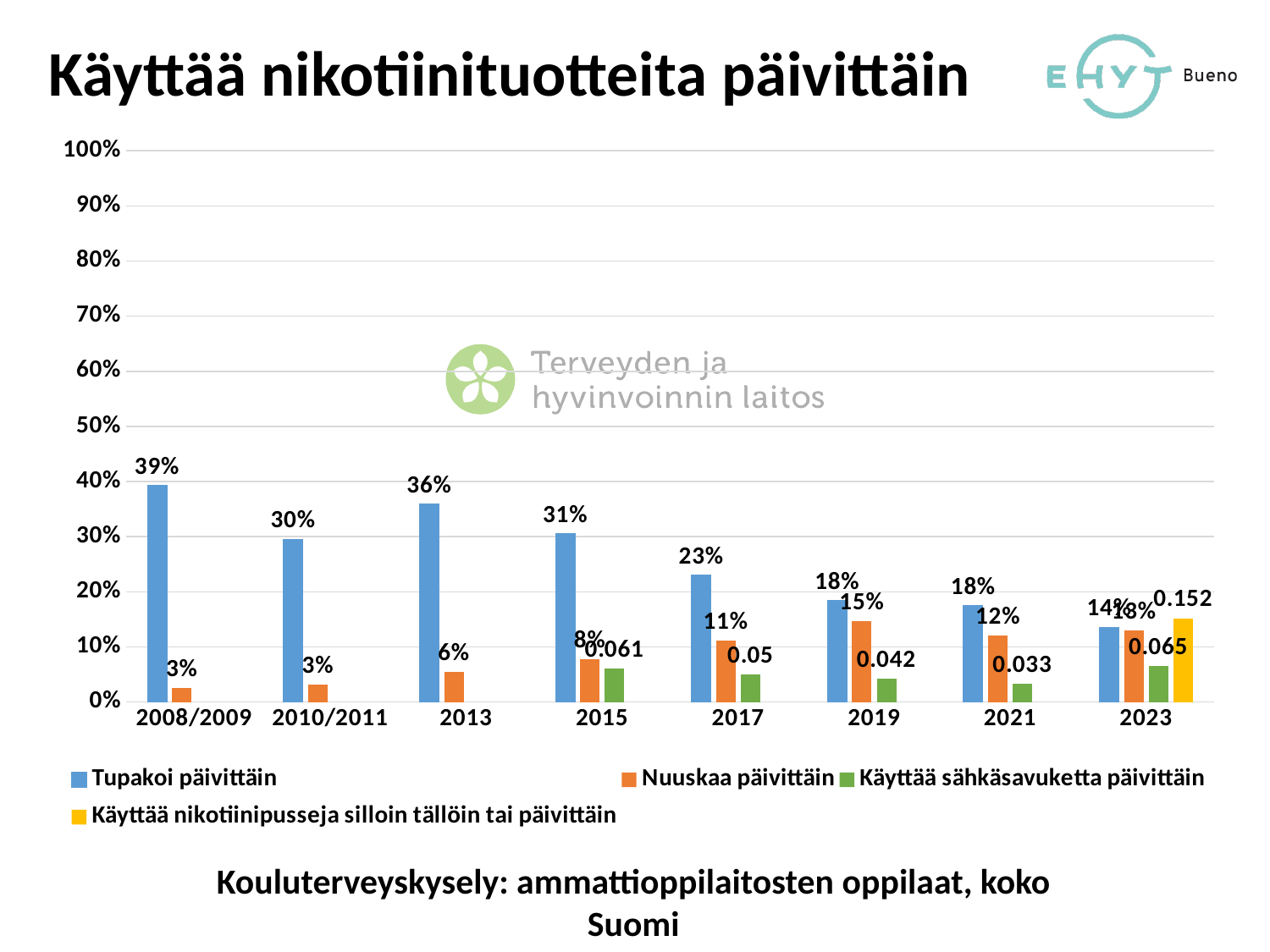
What is the value for Tupakoi päivittäin in 2008/2009? 39% How many categories (survey years) are shown on the x axis? 8 What kind of chart is shown on the slide? bar chart What is the difference between Tupakoi päivittäin in 2013 and in 2015? 5% In 2019, which is larger: Tupakoi päivittäin or Nuuskaa päivittäin? Tupakoi päivittäin In which year is Tupakoi päivittäin lowest? 2023 What is the value for Käyttää sähkäsavuketta päivittäin in 2023? 0.065 How many series does the legend list? 4 Does Tupakoi päivittäin rise or fall overall from 2008/2009 to 2023? fall In which year is Tupakoi päivittäin highest? 2008/2009 What is the value for Nuuskaa päivittäin in 2017? 11% What is the value for Käyttää nikotiinipusseja silloin tällöin tai päivittäin in 2023? 0.152